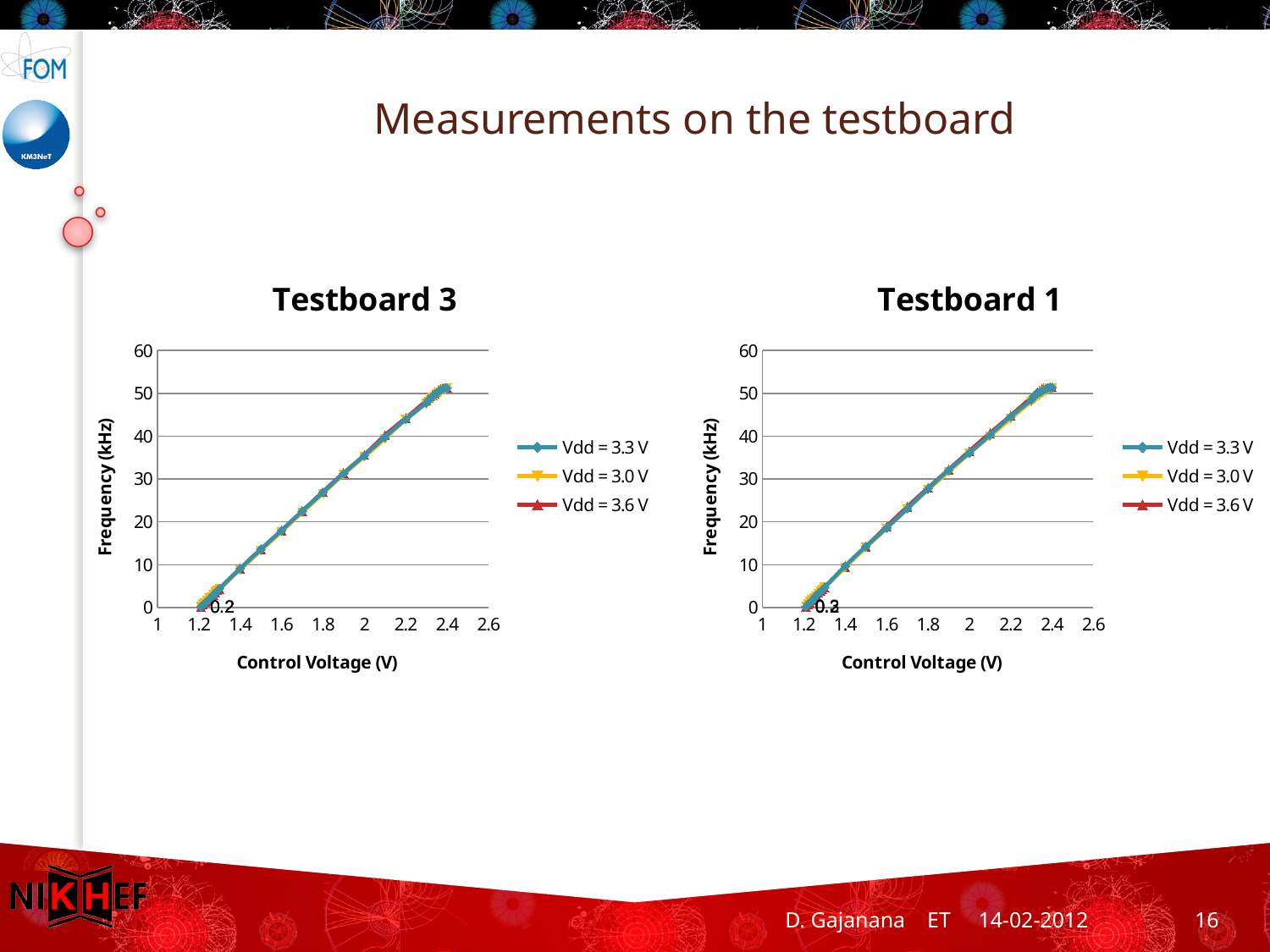
In the Testboard 1 chart, is the frequency at a control voltage of 2.2 V greater or less than 40 kHz? greater In the Testboard 3 chart, is the frequency at a control voltage of 2.0 V greater or less than 30 kHz? greater What kind of chart is the Testboard 3 chart? line chart In the Testboard 1 chart, does the frequency rise or fall as the control voltage increases? rise Which series in the Testboard 3 chart is drawn in red? Vdd = 3.6 V In the Testboard 3 chart, is the frequency at a control voltage of 1.6 V greater or less than 20 kHz? less In the Testboard 3 chart, does the frequency rise or fall as the control voltage increases? rise What is the label of the y axis in the Testboard 1 chart? Frequency (kHz) How many series does the legend of the Testboard 1 chart list? 3